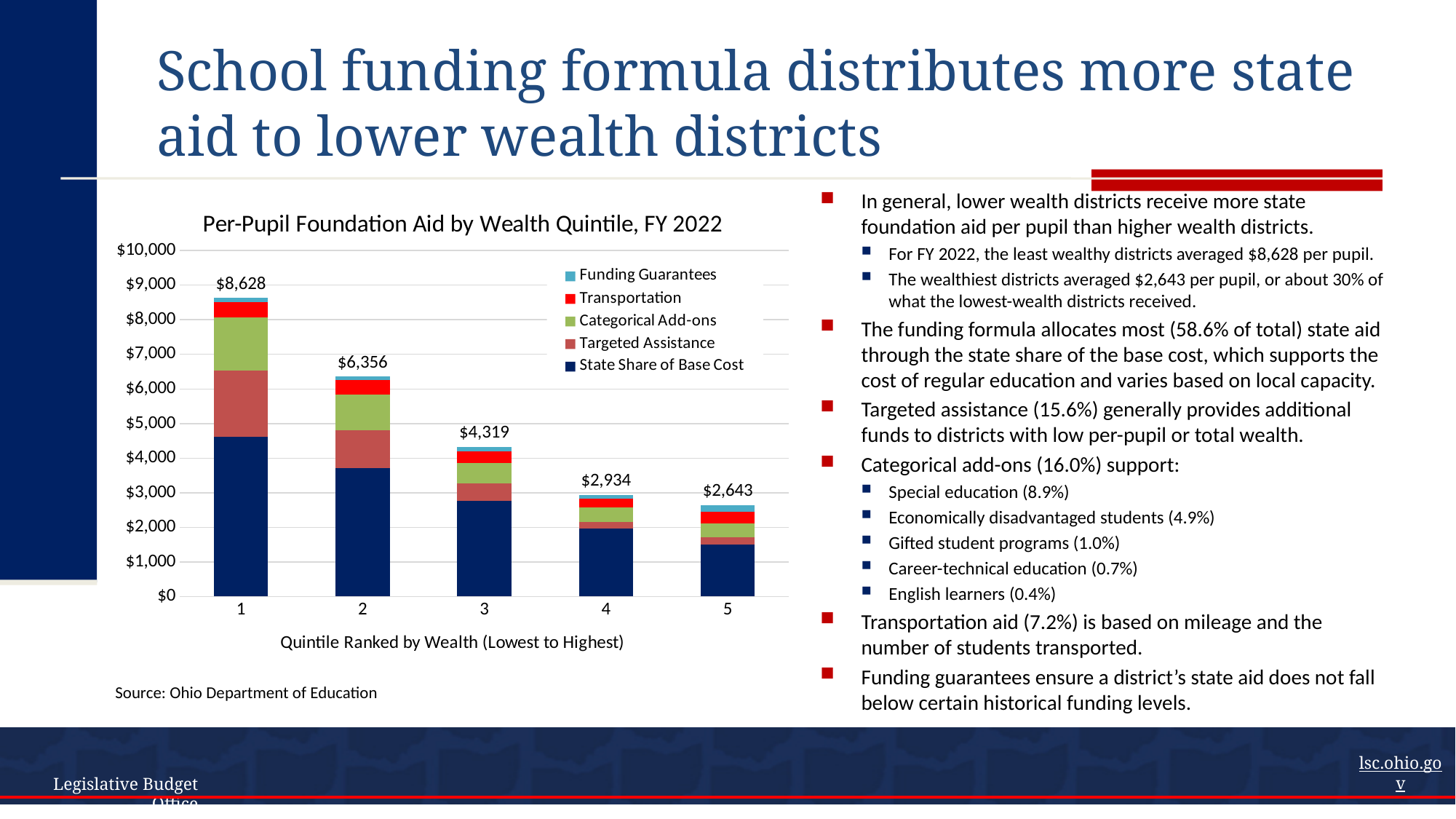
What is the total per-pupil foundation aid for quintile 3? $4,319 Which has a larger total per-pupil aid, quintile 2 or quintile 3? Quintile 2 What type of chart is shown on the slide? Stacked bar chart What is the difference between the total per-pupil aid for quintile 2 and quintile 4? $3,422 Is the State Share of Base Cost for quintile 1 greater or less than $4,000? greater What is the difference between the total per-pupil aid for quintile 1 and quintile 5? $5,985 Which quintile has the highest total per-pupil foundation aid? 1 What is the total per-pupil foundation aid for quintile 5? $2,643 Which quintile has the lowest total per-pupil foundation aid? 5 What is the total per-pupil foundation aid for quintile 1? $8,628 How many series does the legend list? 5 Do the total per-pupil aid values rise or fall as the wealth quintile increases from 1 to 5? Fall